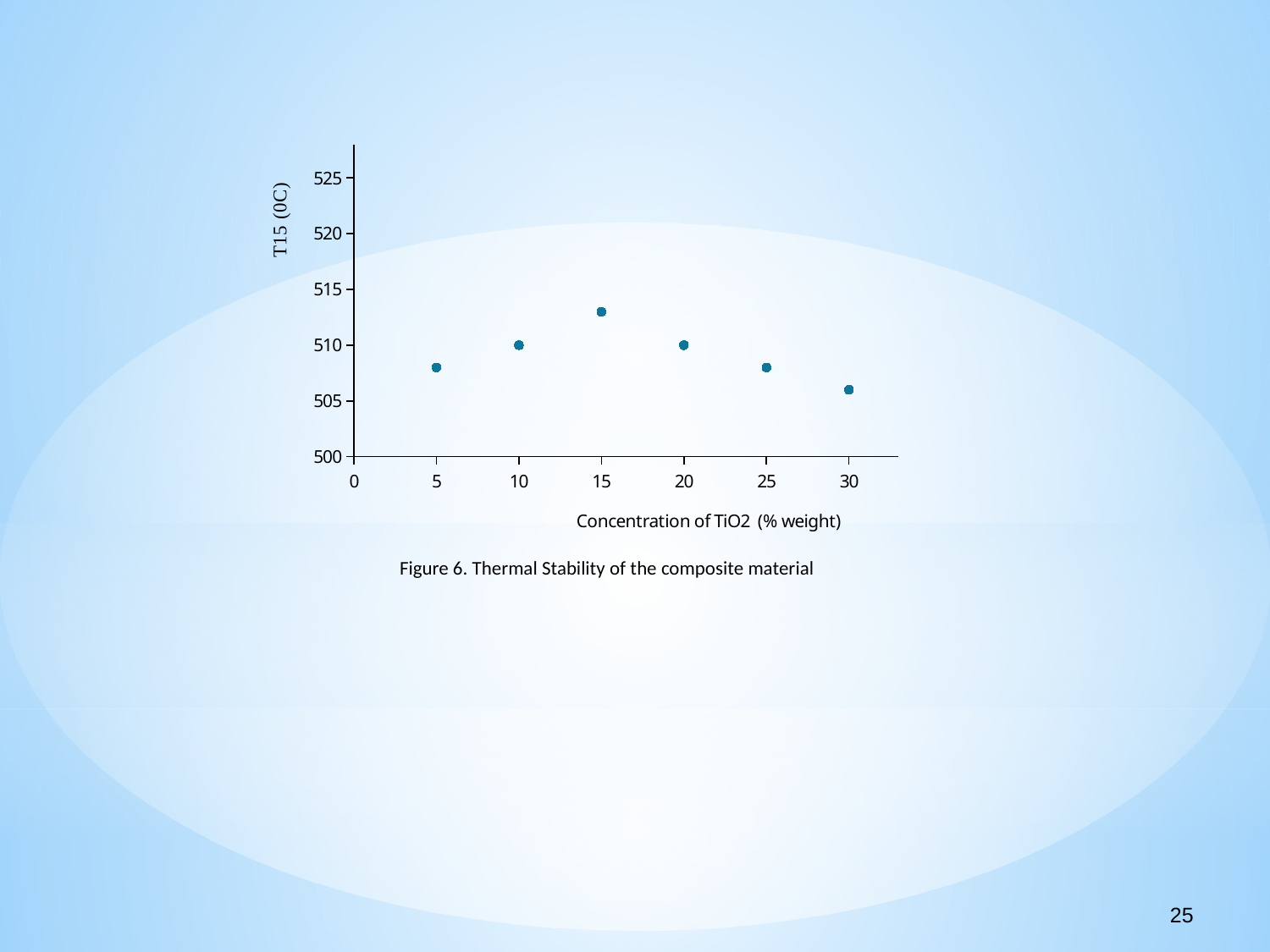
Which has a higher T15 value: a TiO2 concentration of 15 or 30? 15 What is the T15 value at a TiO2 concentration of 20? 510 Is the T15 value at a TiO2 concentration of 30 greater or less than 510? less At which concentration of TiO2 is T15 lowest? 30 Is the T15 value at a TiO2 concentration of 15 greater or less than 510? greater How many data points are plotted on the chart? 6 What kind of chart is shown on the slide? scatter chart At which concentration of TiO2 is T15 highest? 15 How does T15 change as the concentration of TiO2 increases from 15 to 30? it falls What is the T15 value at a TiO2 concentration of 10? 510 What is the label of the x axis? Concentration of TiO2 (% weight) Is the T15 value at a TiO2 concentration of 5 greater or less than 505? greater